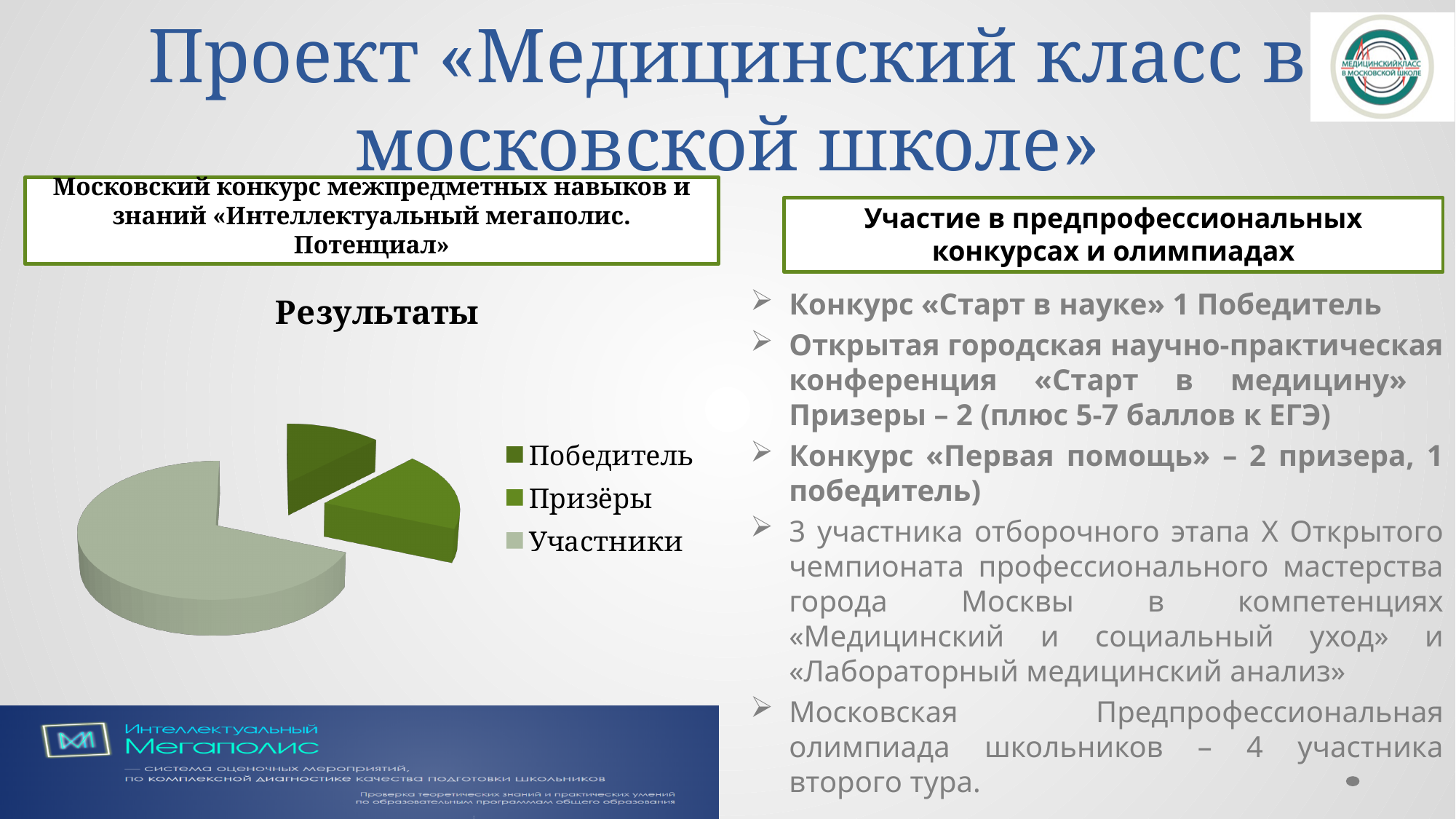
Is the slice for Призёры larger or smaller than the slice for Участники in the pie chart «Результаты»? smaller Is the slice for Участники larger or smaller than the slice for Победитель in the pie chart «Результаты»? larger What kind of chart is shown under the heading «Результаты»? pie chart How many entries does the legend of the pie chart «Результаты» list? 3 How many slices does the pie chart «Результаты» have? 3 Which legend entry of the pie chart «Результаты» is shown in the lightest colour? Участники What is the title of the pie chart on the slide? Результаты Which category takes the largest share of the pie chart «Результаты»? Участники